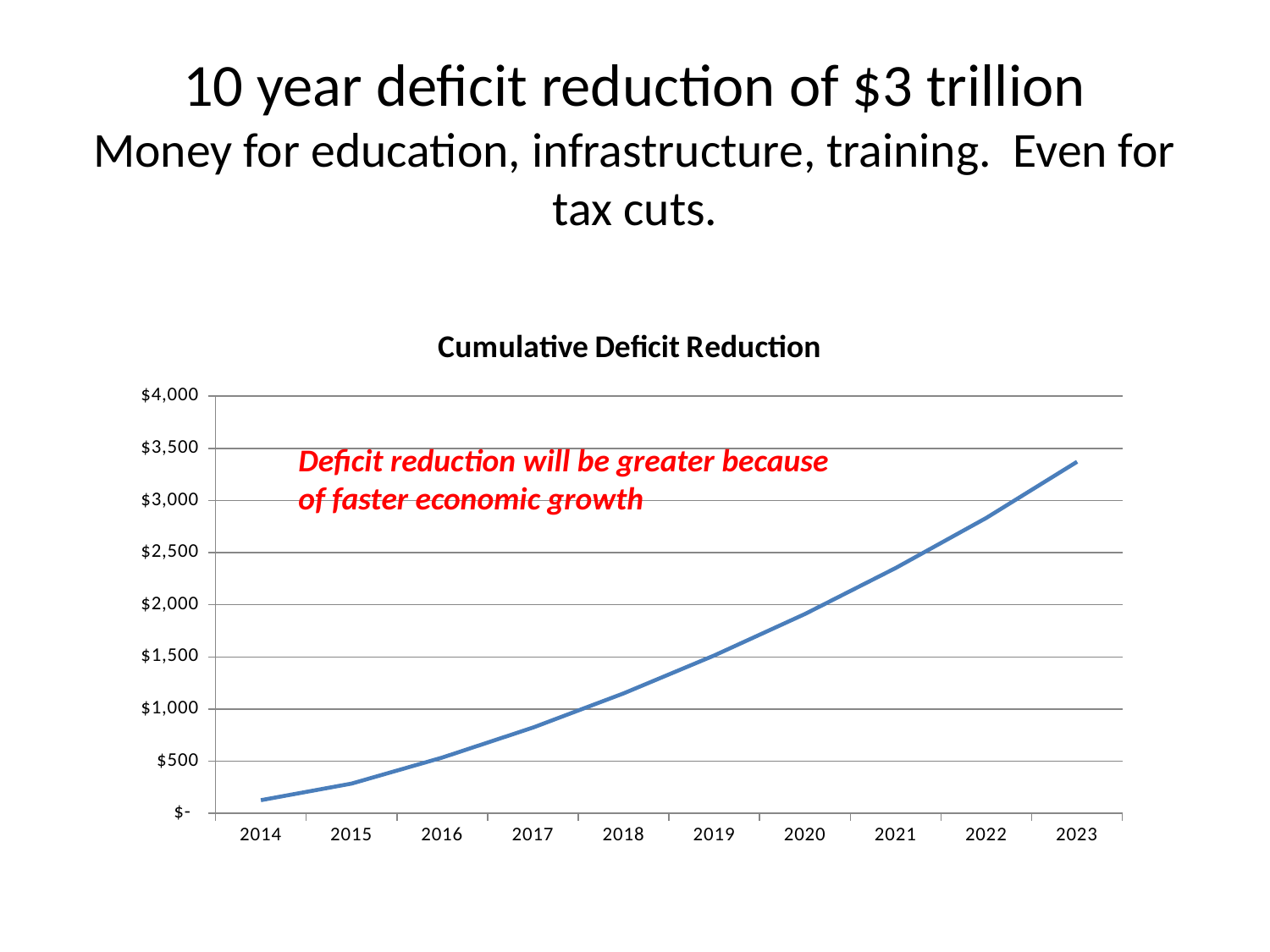
What does the red annotation on the chart say deficit reduction will be greater because of? faster economic growth How many years are plotted on the x axis of the chart? 10 Do the values in the chart rise or fall from 2014 to 2023? rise Is the value for 2023 greater or less than $3,000? greater What is the title of the chart? Cumulative Deficit Reduction Is the value for 2014 greater or less than $500? less Is the value for 2019 greater or less than $1,000? greater Which year has the highest cumulative deficit reduction? 2023 What kind of chart is shown on the slide? line chart Which is larger, the value for 2021 or the value for 2016? 2021 Which year has the lowest cumulative deficit reduction? 2014